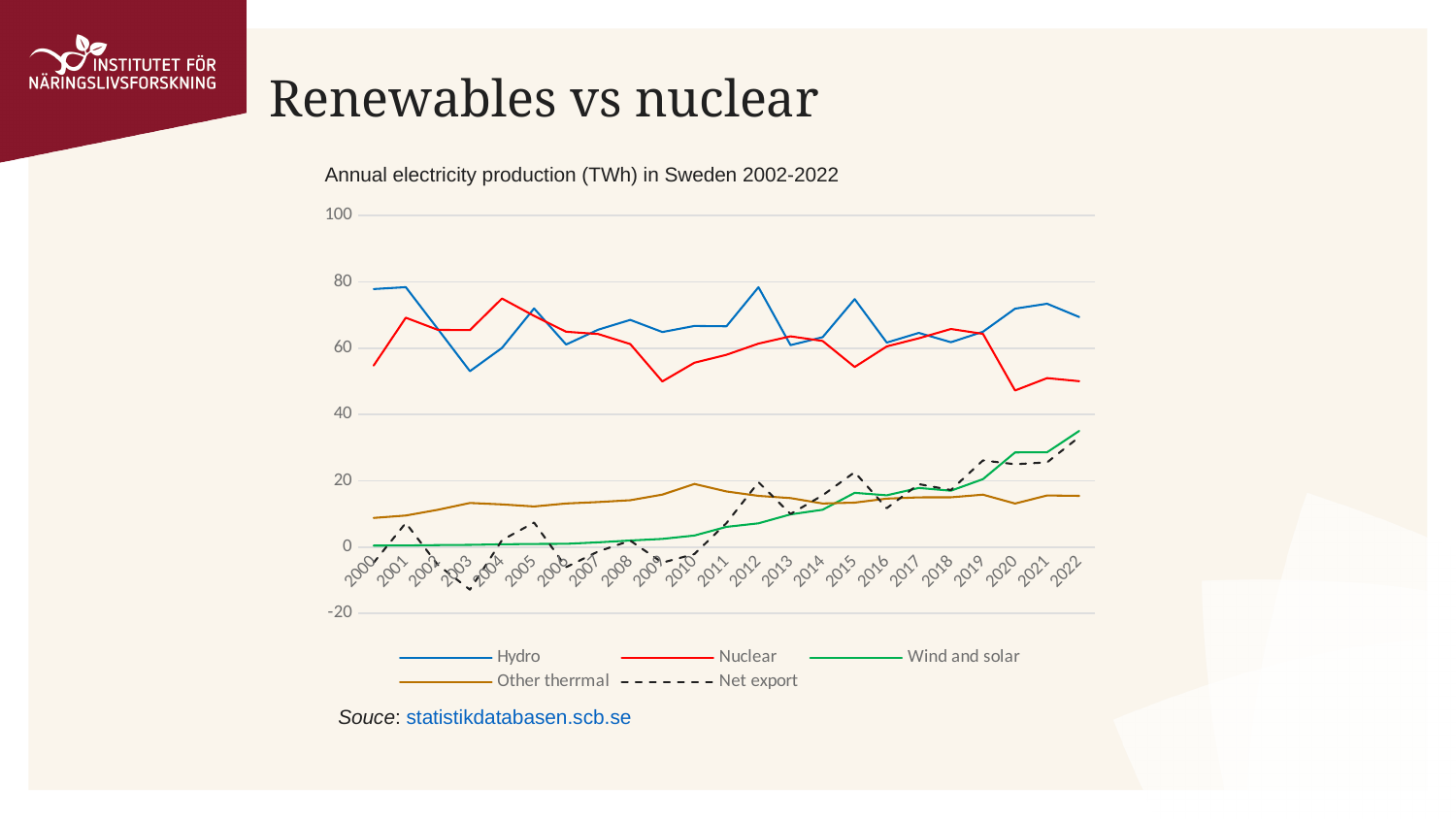
In 2010, which is larger, Other thermal or Wind and solar? Other thermal How many series does the legend of the chart list? 5 Does the Wind and solar series rise or fall from 2000 to 2022? rise In 2022, which is larger, Hydro or Nuclear? Hydro How many years are plotted along the x axis of the chart? 23 Is the value for Net export in 2003 greater or less than 0? less Is the value for Nuclear in 2022 greater or less than 60? less Which series in the chart is drawn with a dashed line? Net export What kind of chart is shown on the slide? line chart Is the value for Hydro in 2000 greater or less than 60? greater Does the Nuclear series rise or fall from 2019 to 2020? fall